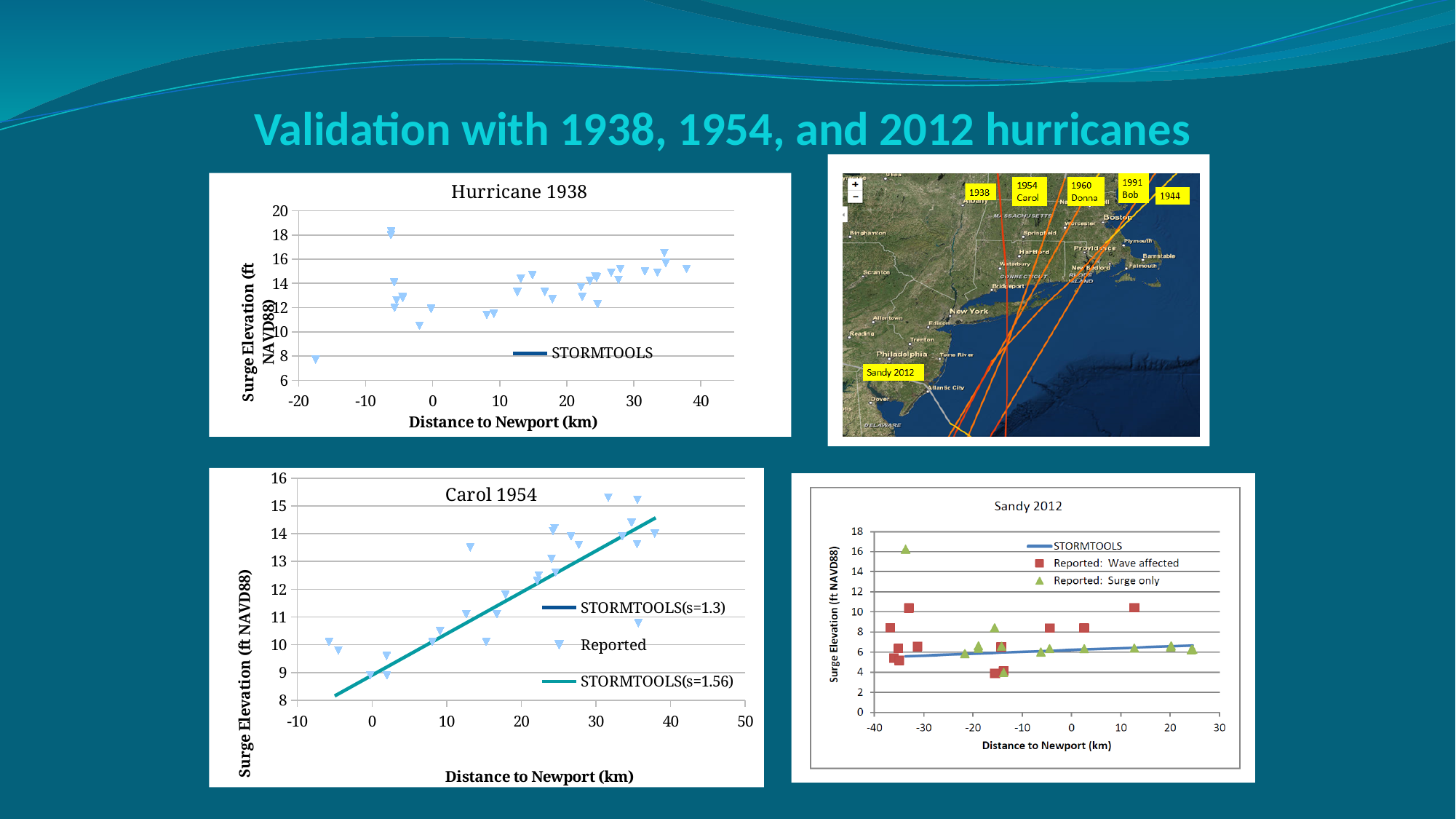
What kind of chart is the Hurricane 1938 chart? scatter chart How many entries does the legend of the Carol 1954 chart list? 3 How many entries does the legend of the Sandy 2012 chart list? 3 In the Sandy 2012 chart, is the 'Reported: Wave affected' point near 13 km greater or less than 10 ft? greater In the Carol 1954 chart, is the highest reported point (near 32 km) greater or less than 15 ft? greater In the Sandy 2012 chart, is the highest 'Reported: Surge only' point (near -33 km) greater or less than 14 ft? greater In the Carol 1954 chart, does the STORMTOOLS(s=1.56) line rise or fall as distance to Newport increases? rise In the Hurricane 1938 chart, what is the label of the x axis? Distance to Newport (km) In the Carol 1954 chart, what is the label of the y axis? Surge Elevation (ft NAVD88) In the Hurricane 1938 chart, do the reported surge elevations generally rise or fall as distance to Newport increases from 0 to 40 km? rise